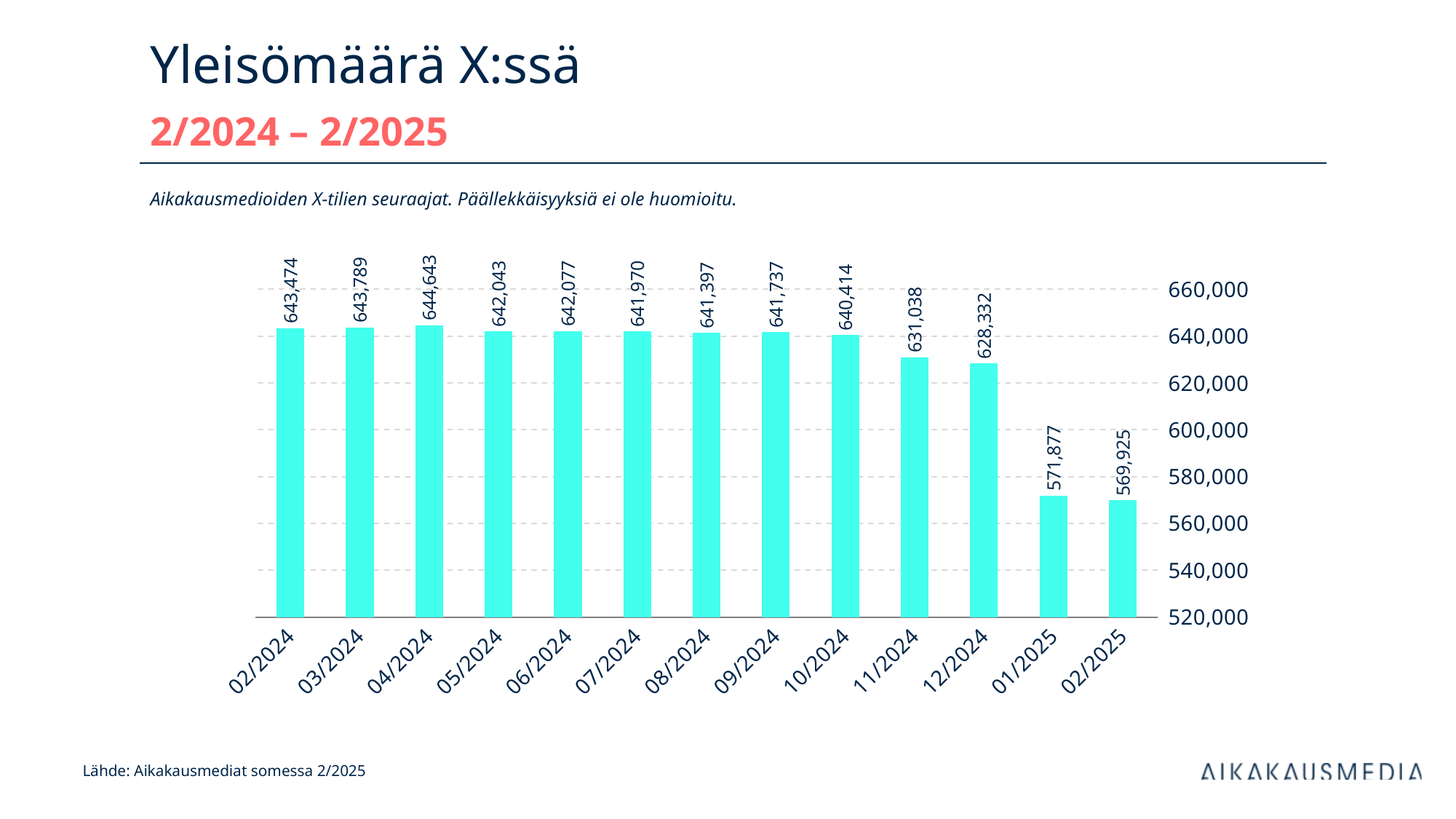
What kind of chart is shown on the slide? bar chart What is the value for 11/2024? 631,038 Is the value for 01/2025 greater or less than 580,000? less What is the difference between the values for 12/2024 and 01/2025? 56,455 Which month has the highest value? 04/2024 How many months are shown on the x axis? 13 Which is larger, the value for 11/2024 or the value for 12/2024? 11/2024 What is the value for 04/2024? 644,643 Do the values generally rise or fall from 02/2024 to 02/2025? fall What is the difference between the values for 02/2024 and 02/2025? 73,549 Which month has the lowest value? 02/2025 What is the value for 02/2025? 569,925